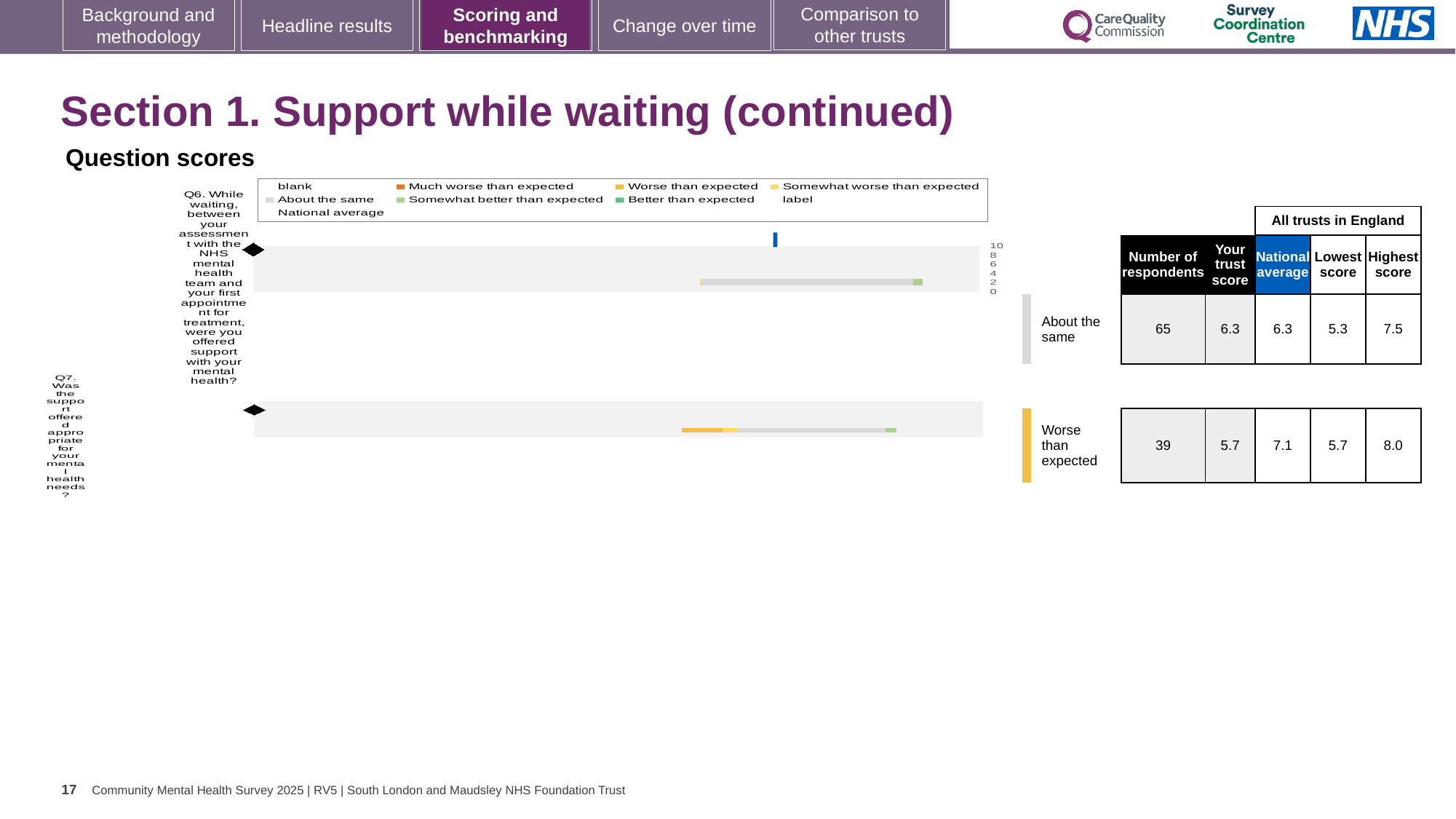
What is the maximum value shown on the score axis of the question scores chart? 10 What is the highest score across all trusts in England for Q7? 8.0 How many respondents answered Q6 according to the table beside the chart? 65 Which benchmark category is Q7 placed in? Worse than expected How many questions (categories) are plotted in the question scores chart? 2 Which question has the higher trust score, Q6 or Q7? Q6 What is the national average for Q7 shown in the table beside the chart? 7.1 What kind of chart is used to show the question scores on this slide? bar chart What is the difference between the national average and the trust score for Q7? 1.4 Which two questions are shown in the question scores chart? Q6 and Q7 According to the table beside the chart, what is the trust score for Q7 (was the support offered appropriate)? 5.7 According to the table beside the chart, what is the trust score for Q6 (support with mental health while waiting)? 6.3